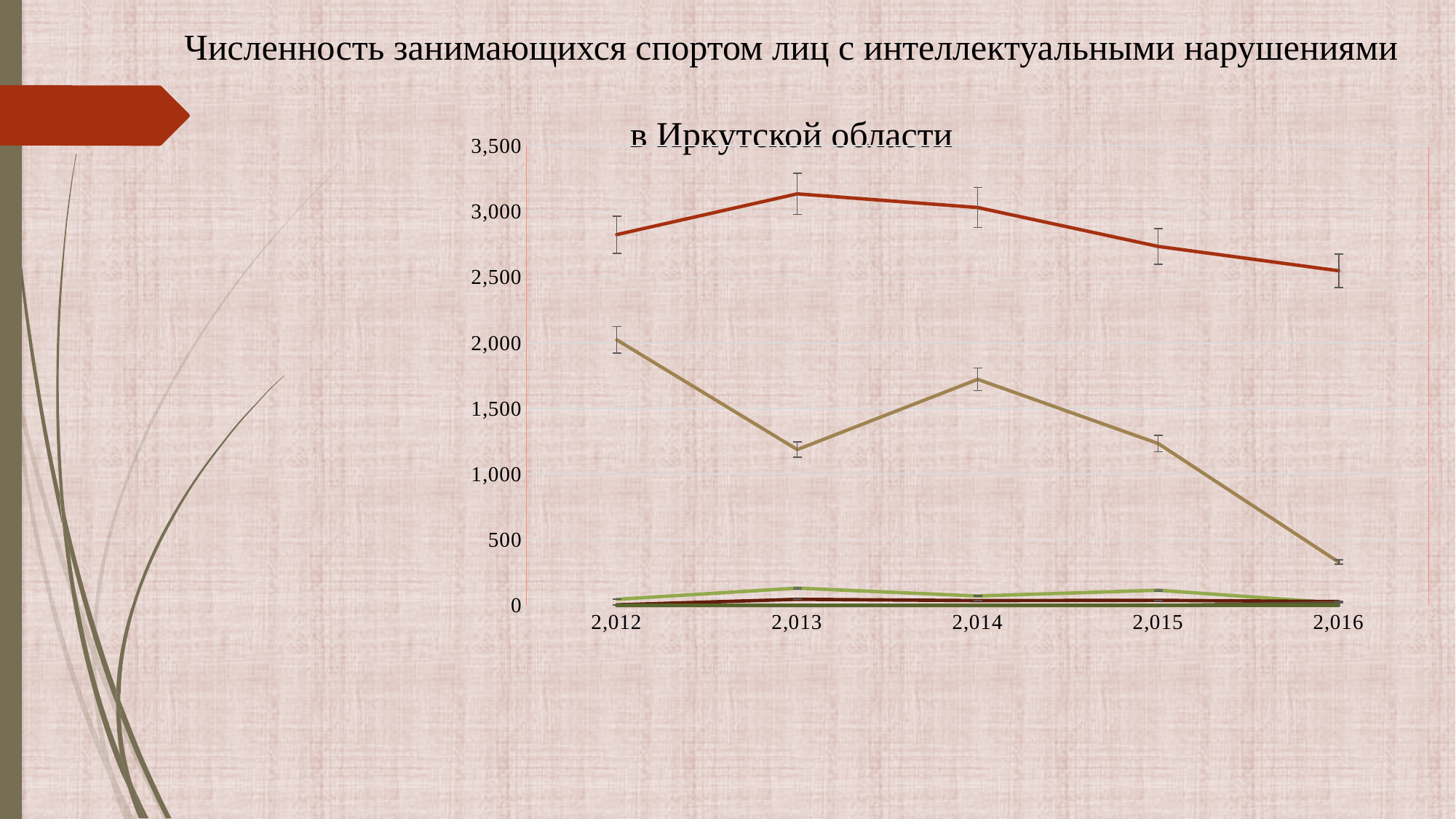
In which year does the tan (middle) line reach its highest value? 2,012 What kind of chart is shown on the slide? line chart In which year does the red (top) line reach its highest value? 2,013 In which year does the red (top) line reach its lowest value? 2,016 Is the value of the tan line in 2,013 greater or less than 1,500? less Which is larger in 2,016: the value of the red line or the value of the tan line? the red line Does the red line rise or fall from 2,013 to 2,016? fall How many years are shown along the x axis of the chart? 5 Is the value of the tan line in 2,016 greater or less than 500? less Is the value of the red line in 2,012 greater or less than 3,000? less In which year does the tan (middle) line reach its lowest value? 2,016